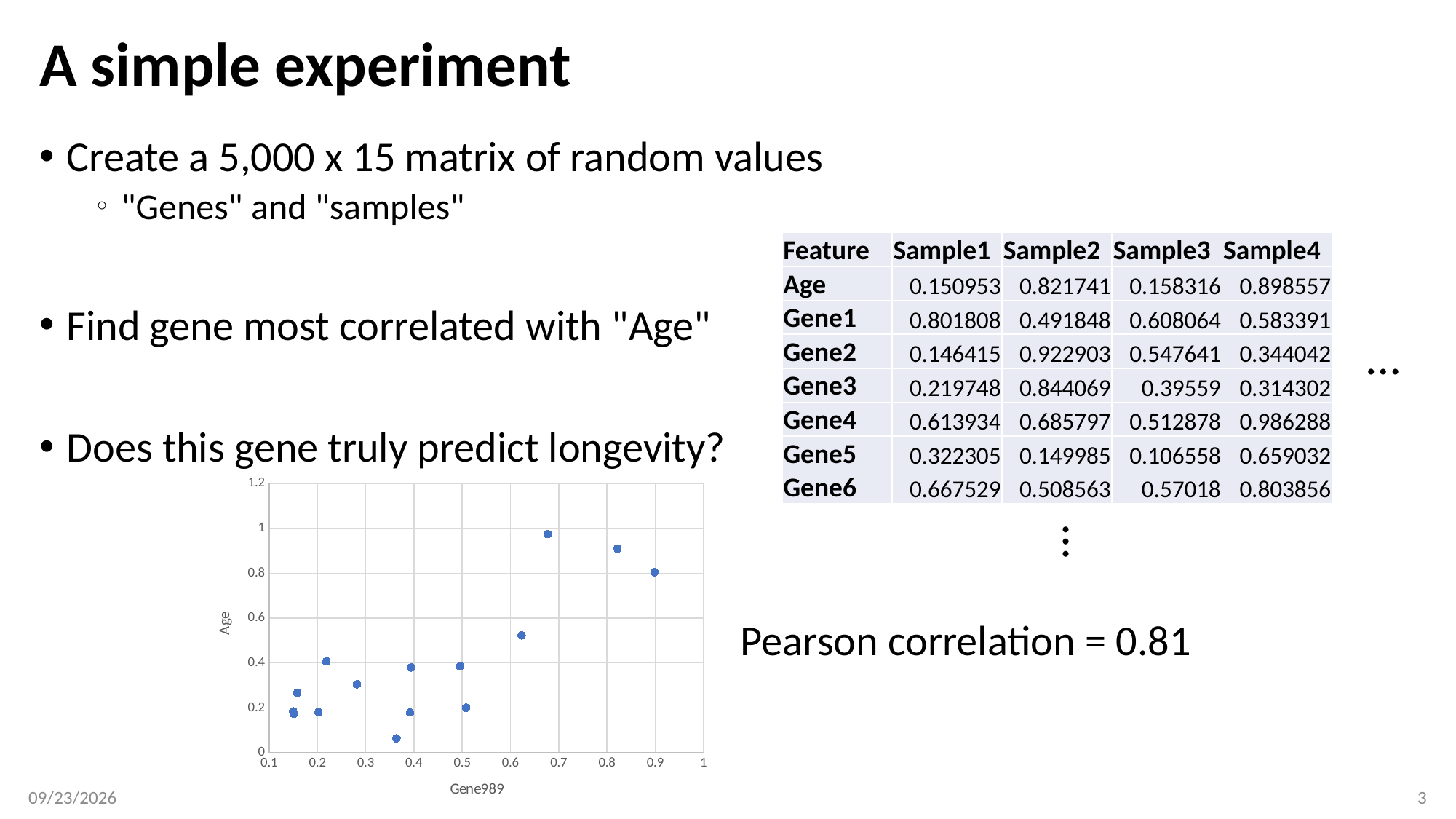
Which has the higher Age value: the point near Gene989 = 0.68 or the point near Gene989 = 0.36? the point near Gene989 = 0.68 Is the Age value of the point with the smallest Gene989 value greater or less than 0.4? less What is the label on the x axis of the scatter chart? Gene989 What kind of chart is shown on the slide? scatter chart Is the lowest Age value plotted in the scatter chart greater or less than 0.2? less Is the largest Gene989 value plotted in the scatter chart greater or less than 0.8? greater What is the maximum value shown on the y axis of the scatter chart? 1.2 What is the label on the y axis of the scatter chart? Age How many points are plotted in the scatter chart? 15 Do the Age values generally rise or fall as Gene989 increases along the x axis? rise